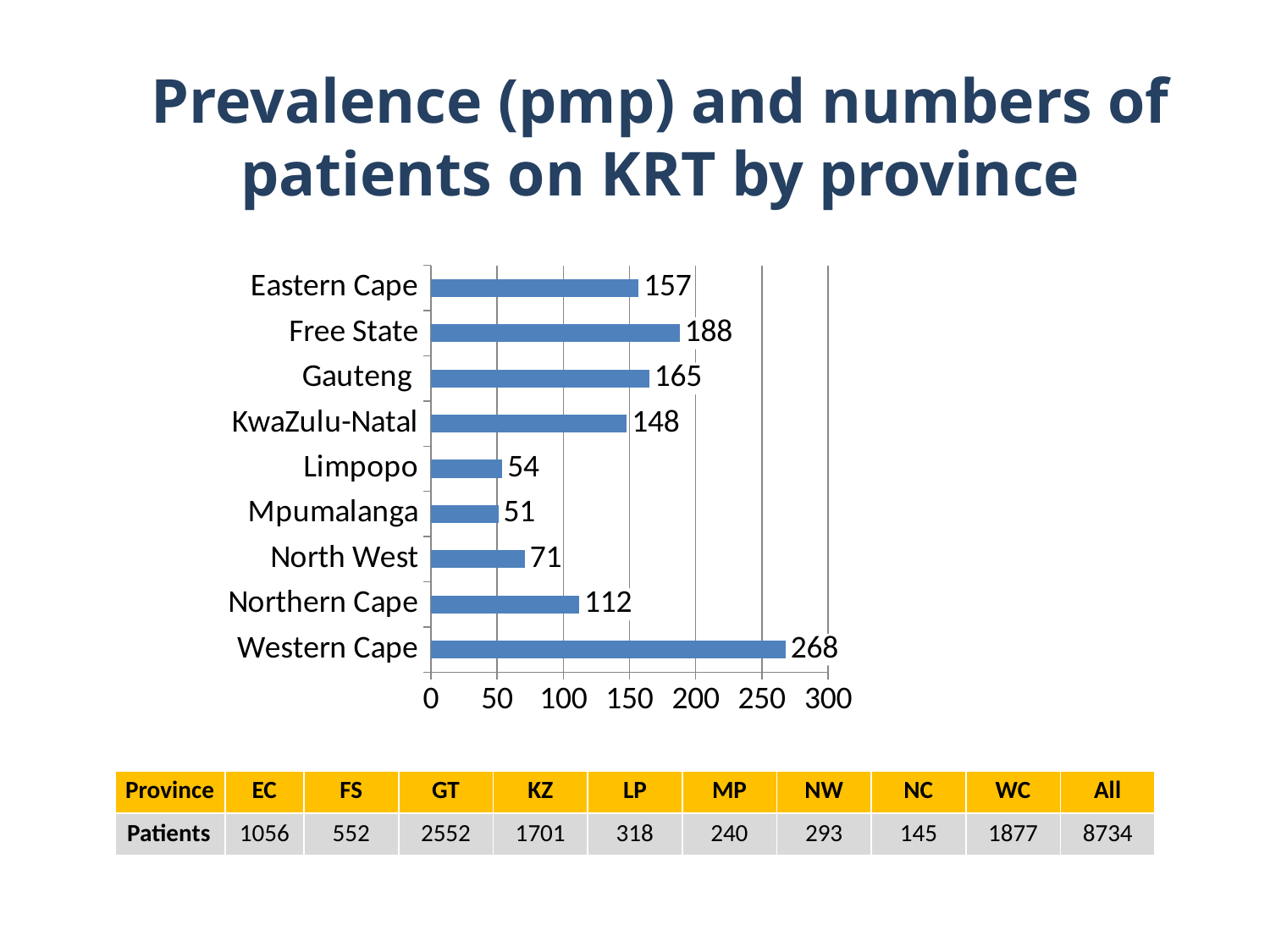
What kind of chart is shown on the slide? bar chart What is the difference in prevalence (pmp) between Gauteng and KwaZulu-Natal? 17 Which province has the lowest prevalence (pmp)? Mpumalanga What is the prevalence (pmp) for Western Cape? 268 Is the prevalence (pmp) for North West greater or less than 100? less Which province has the highest prevalence (pmp)? Western Cape What is the prevalence (pmp) for Mpumalanga? 51 What is the prevalence (pmp) for Free State? 188 How many provinces are shown in the chart? 9 What is the difference in prevalence (pmp) between Western Cape and Northern Cape? 156 Which has a higher prevalence (pmp), Eastern Cape or Gauteng? Gauteng What is the maximum value shown on the x axis of the chart? 300